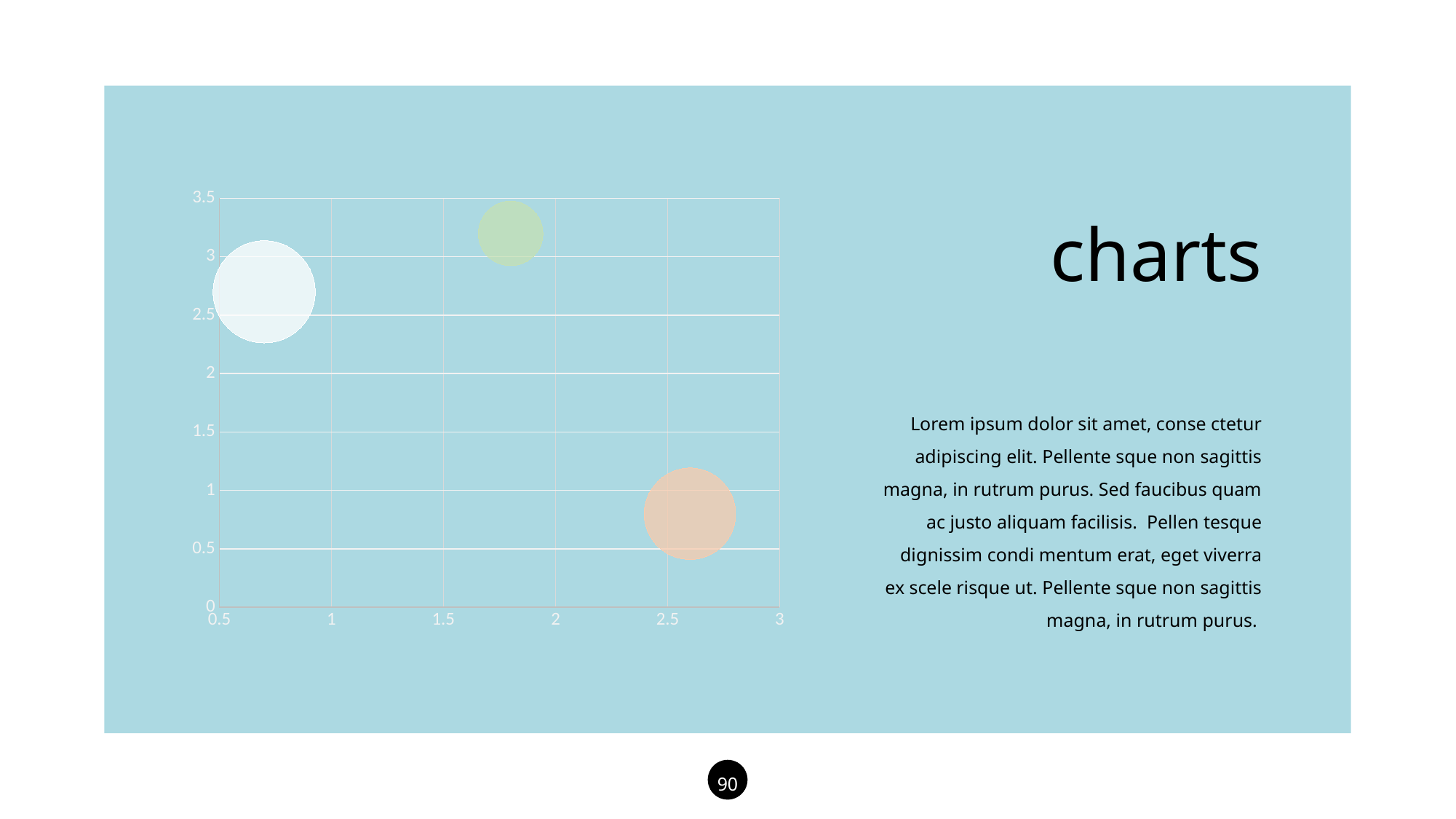
Is the vertical-axis value of the white bubble greater or less than 2? greater Is the horizontal-axis value of the orange bubble greater or less than 2? greater What is the highest value shown on the vertical axis? 3.5 What kind of chart is shown on the slide? bubble chart Which bubble sits highest on the vertical axis: the white, green or orange one? green Which bubble is positioned higher on the vertical axis, the white one or the orange one? white How many bubbles are plotted on the chart? 3 Which bubble sits lowest on the vertical axis: the white, green or orange one? orange What is the title text shown next to the chart on the slide? charts Is the vertical-axis value of the orange bubble greater or less than 1.5? less